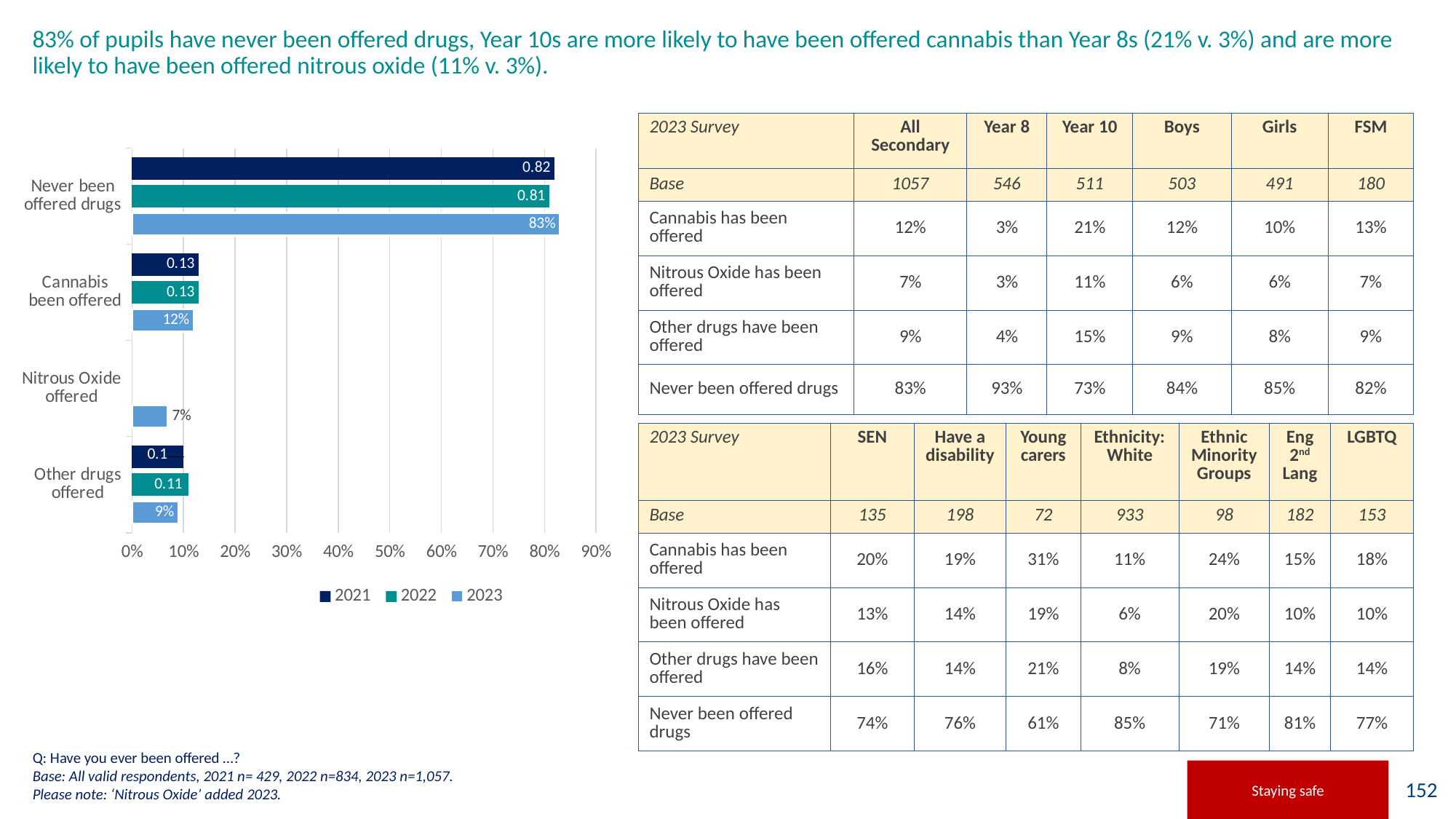
What is the 2023 value for 'Nitrous Oxide offered' in the chart? 7% What is the 2022 value for 'Cannabis been offered' in the chart? 0.13 In the chart, is the 2023 value for 'Cannabis been offered' larger or smaller than the 2023 value for 'Other drugs offered'? larger How many categories are shown on the chart's vertical axis? 4 Which series in the chart is shown in the darkest blue colour? 2021 Which category has the lowest 2023 value in the chart? Nitrous Oxide offered What is the 2021 value for 'Other drugs offered' in the chart? 0.1 How many series does the chart legend list? 3 What kind of chart is shown on the slide? bar chart What is the 2021 value for 'Never been offered drugs' in the chart? 0.82 Which category has the highest 2023 value in the chart? Never been offered drugs What is the 2023 value for 'Never been offered drugs' in the chart? 83%